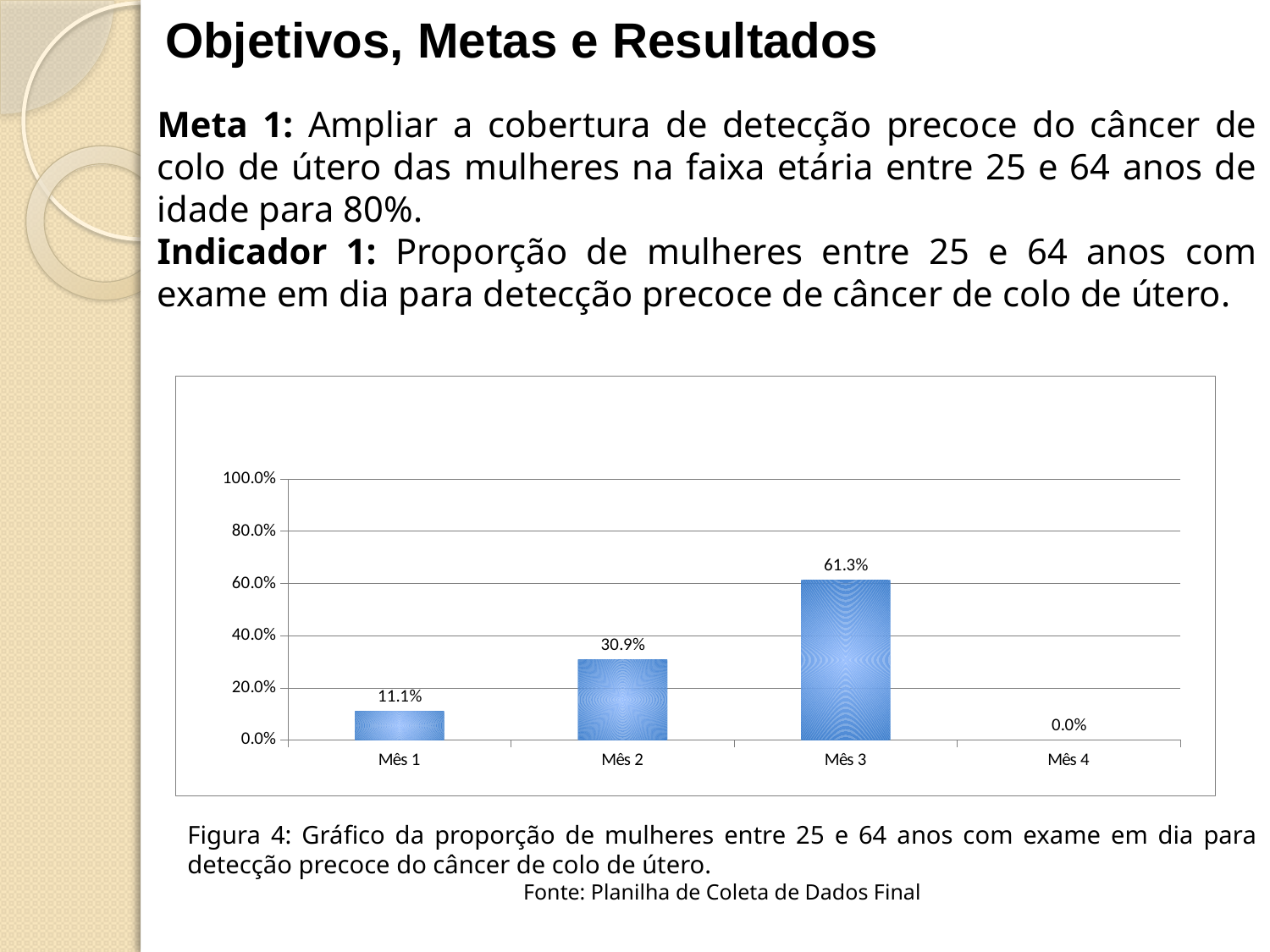
What is the value for Mês 4? 0.0% How many months are shown on the x axis? 4 Which month has the lowest value? Mês 4 What is the value for Mês 2? 30.9% Which month has the highest value? Mês 3 Is the value for Mês 3 greater or less than 60.0%? greater What kind of chart is shown? Bar chart What is the value for Mês 3? 61.3% What is the difference between the values for Mês 3 and Mês 2? 30.4% What is the value for Mês 1? 11.1% What is the difference between the values for Mês 2 and Mês 1? 19.8% Which is larger, the value for Mês 1 or the value for Mês 2? Mês 2